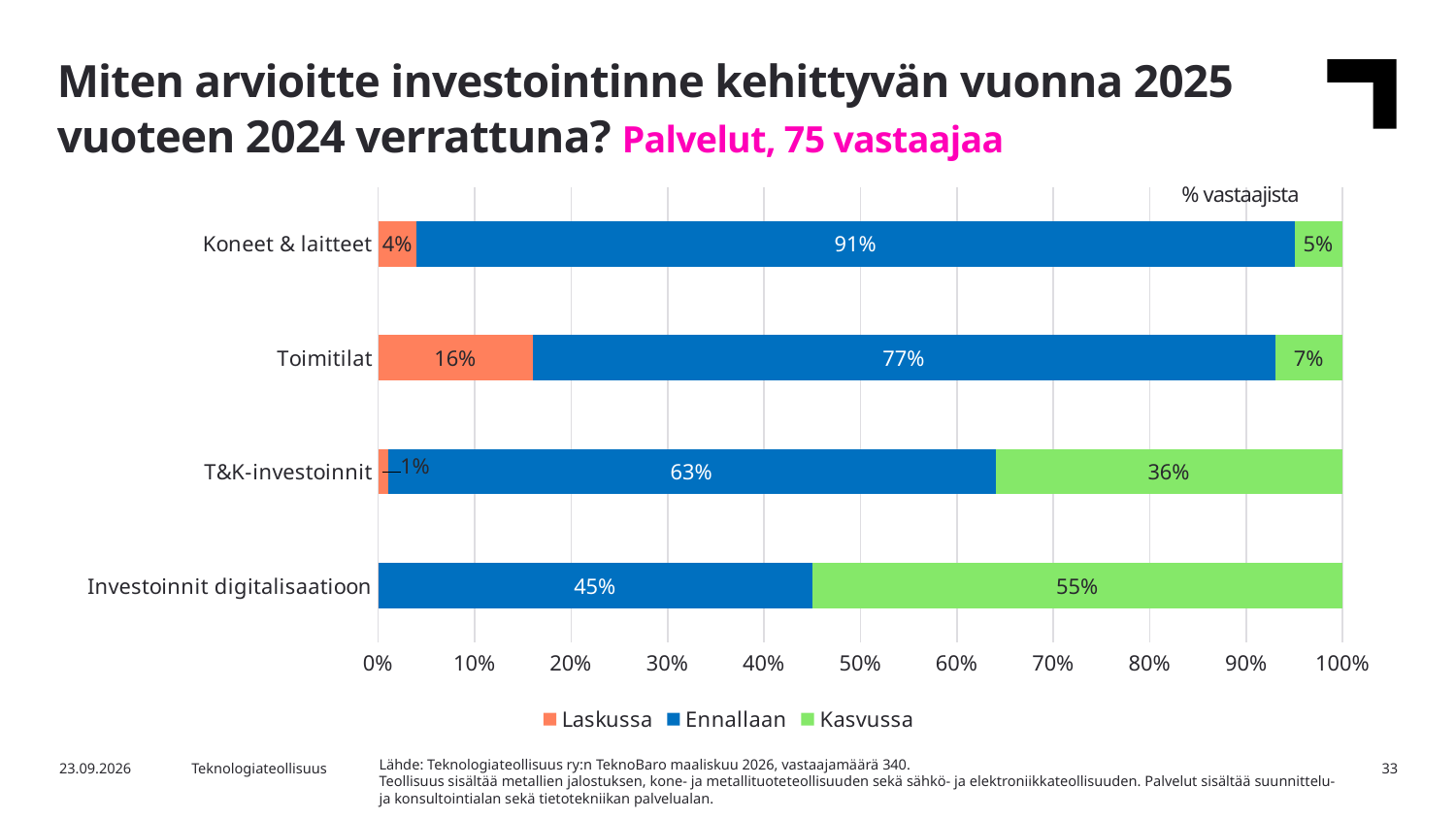
How many series does the legend list? 3 Which category has the lowest Ennallaan value? Investoinnit digitalisaatioon What is the Ennallaan value for Koneet & laitteet? 91% What type of chart is shown on the slide? Stacked bar chart How many categories are plotted on the chart? 4 Which category has the highest Kasvussa value? Investoinnit digitalisaatioon What is the Kasvussa value for Investoinnit digitalisaatioon? 55% What is the difference between the Ennallaan values for Koneet & laitteet and Toimitilat? 14 percentage points What is the Kasvussa value for T&K-investoinnit? 36% Which is larger: the Laskussa value for Toimitilat or the Laskussa value for Koneet & laitteet? Toimitilat Which legend entry is shown in green? Kasvussa What is the Laskussa value for Toimitilat? 16%